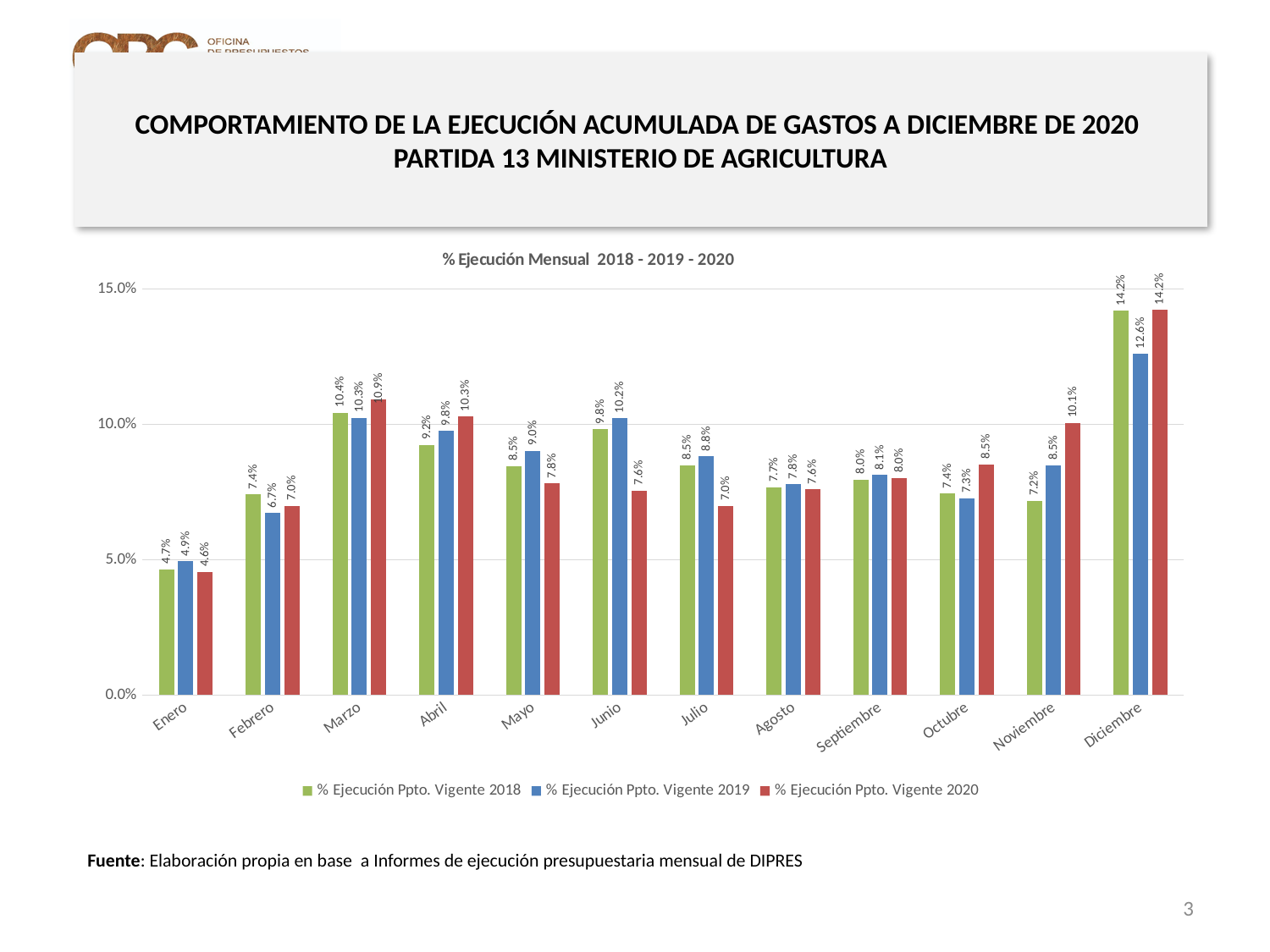
What is the value for Noviembre in the % Ejecución Ppto. Vigente 2019 series? 8.5% Which is larger for Junio: the 2019 value or the 2020 value? 2019 value (10.2%) What is the difference between the 2018 and 2019 values for Diciembre? 1.6% Which month has the lowest value in the % Ejecución Ppto. Vigente 2020 series? Enero Which month has the highest value in the % Ejecución Ppto. Vigente 2019 series? Diciembre Is the value for Abril in the 2020 series greater or less than 10.0%? greater How many series does the legend list? 3 What is the title of the chart? % Ejecución Mensual 2018 - 2019 - 2020 How many months are shown on the x axis? 12 What is the value for Marzo in the % Ejecución Ppto. Vigente 2020 series? 10.9% What is the value for Enero in the % Ejecución Ppto. Vigente 2018 series? 4.7% What kind of chart is shown on the slide? Bar chart